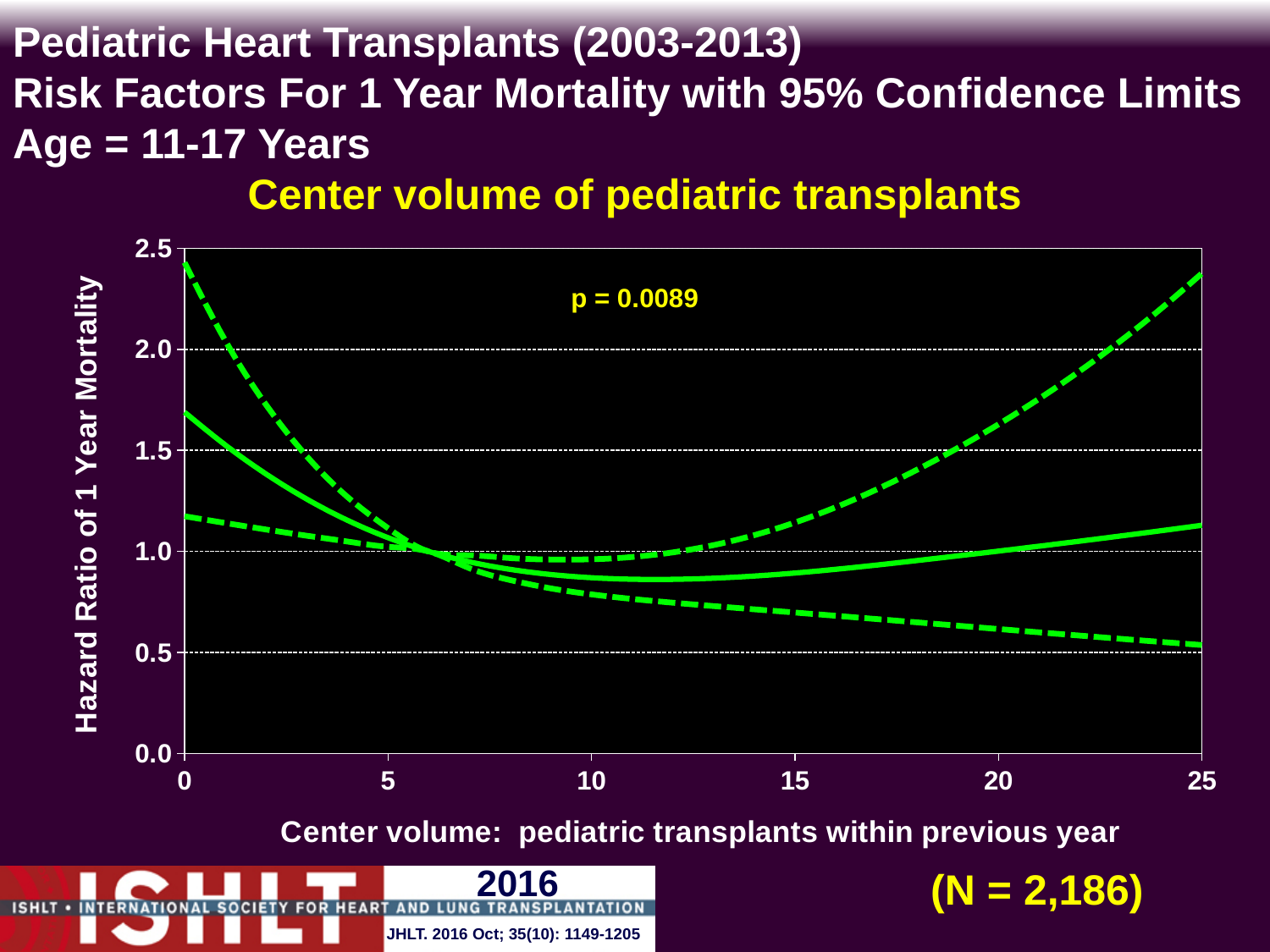
What is the sample size (N) shown on the slide? N = 2,186 How many lines are plotted on the chart? 3 Is the hazard ratio of the solid line at a center volume of 0 greater or less than 1.5? greater Is the lower dashed confidence limit at a center volume of 25 greater or less than 1.0? less Is the upper dashed confidence limit at a center volume of 0 greater or less than 2.0? greater What kind of chart is shown on the slide? line chart At a center volume of 25, which is higher: the upper dashed confidence limit or the solid hazard ratio line? the upper dashed confidence limit Does the upper dashed confidence limit rise or fall as center volume increases from 15 to 25? rise What is the p-value printed on the chart? p = 0.0089 Does the solid hazard ratio line rise or fall as center volume increases from 0 to 10? fall